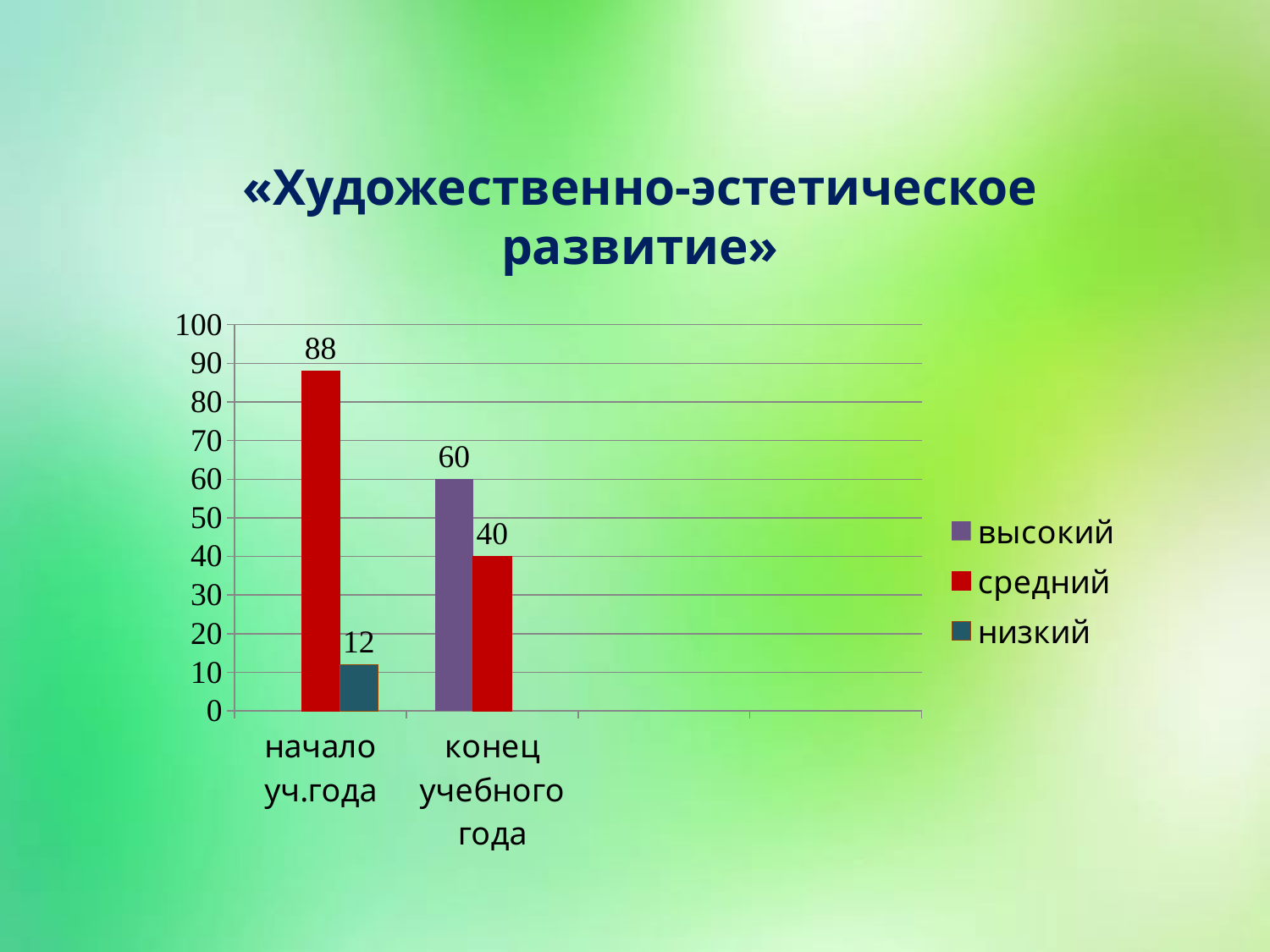
What is the difference between the средний values at начало уч.года and конец учебного года? 48 Which series has the lowest plotted value at конец учебного года? средний What is the value for высокий at конец учебного года? 60 What is the value for низкий at начало уч.года? 12 Which is larger at конец учебного года: высокий or средний? высокий How many series does the legend list? 3 Which series has the highest value at начало уч.года? средний What kind of chart is shown on the slide? bar chart What is the value for средний at начало уч.года? 88 How many categories are shown on the x axis? 2 Does the средний value rise or fall from начало уч.года to конец учебного года? fall What is the value for средний at конец учебного года? 40